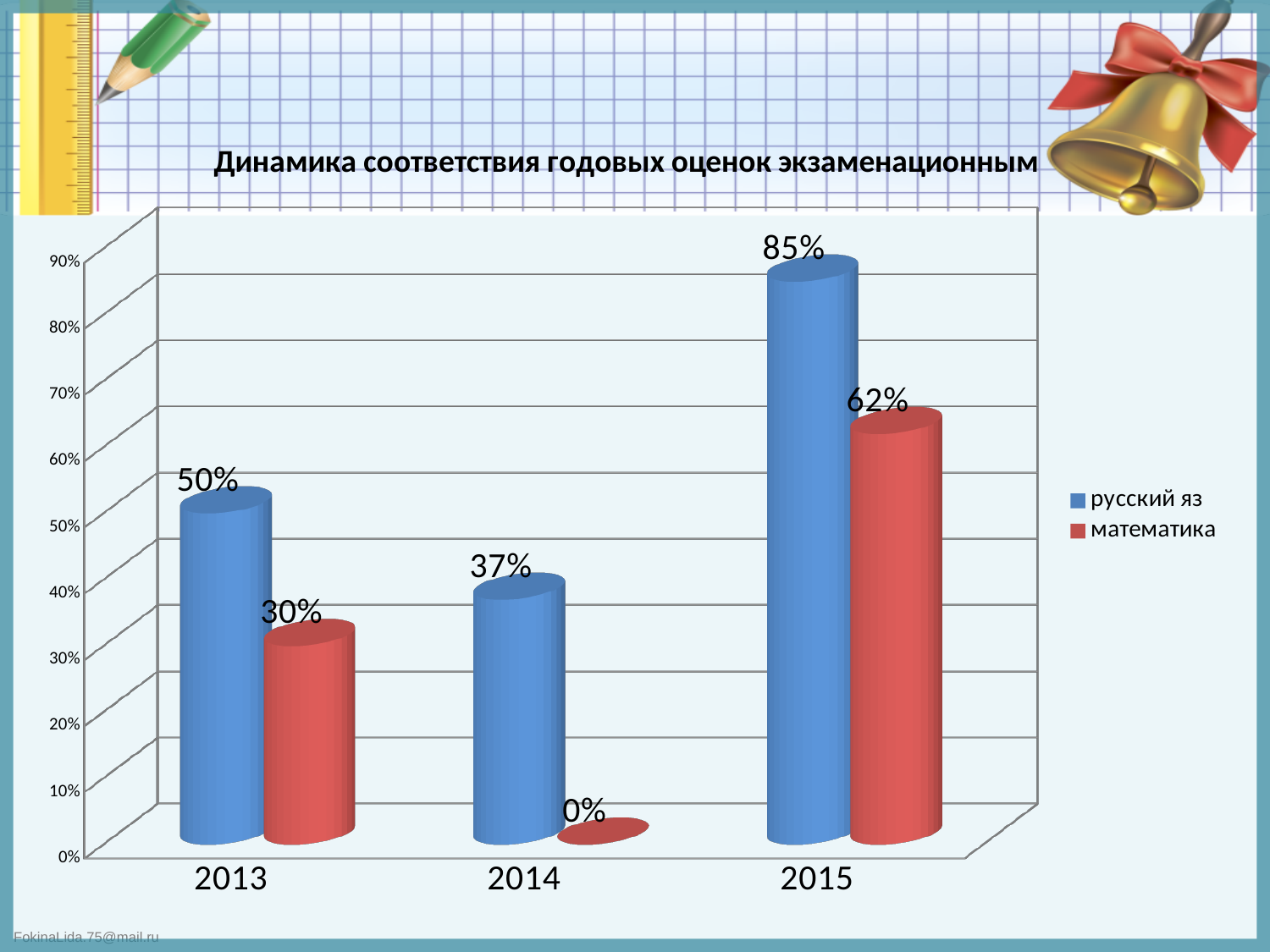
How many series does the legend list? 2 What is the difference between русский яз and математика in 2015? 23% What is the title of the chart? Динамика соответствия годовых оценок экзаменационным What is the value for математика in 2014? 0% In which year is the value for математика lowest? 2014 What is the difference between русский яз in 2015 and русский яз in 2013? 35% Which is larger in 2013: русский яз or математика? русский яз How many years are shown on the x axis? 3 In which year is the value for русский яз highest? 2015 What is the value for математика in 2015? 62% What kind of chart is shown on the slide? bar chart What is the value for русский яз in 2013? 50%